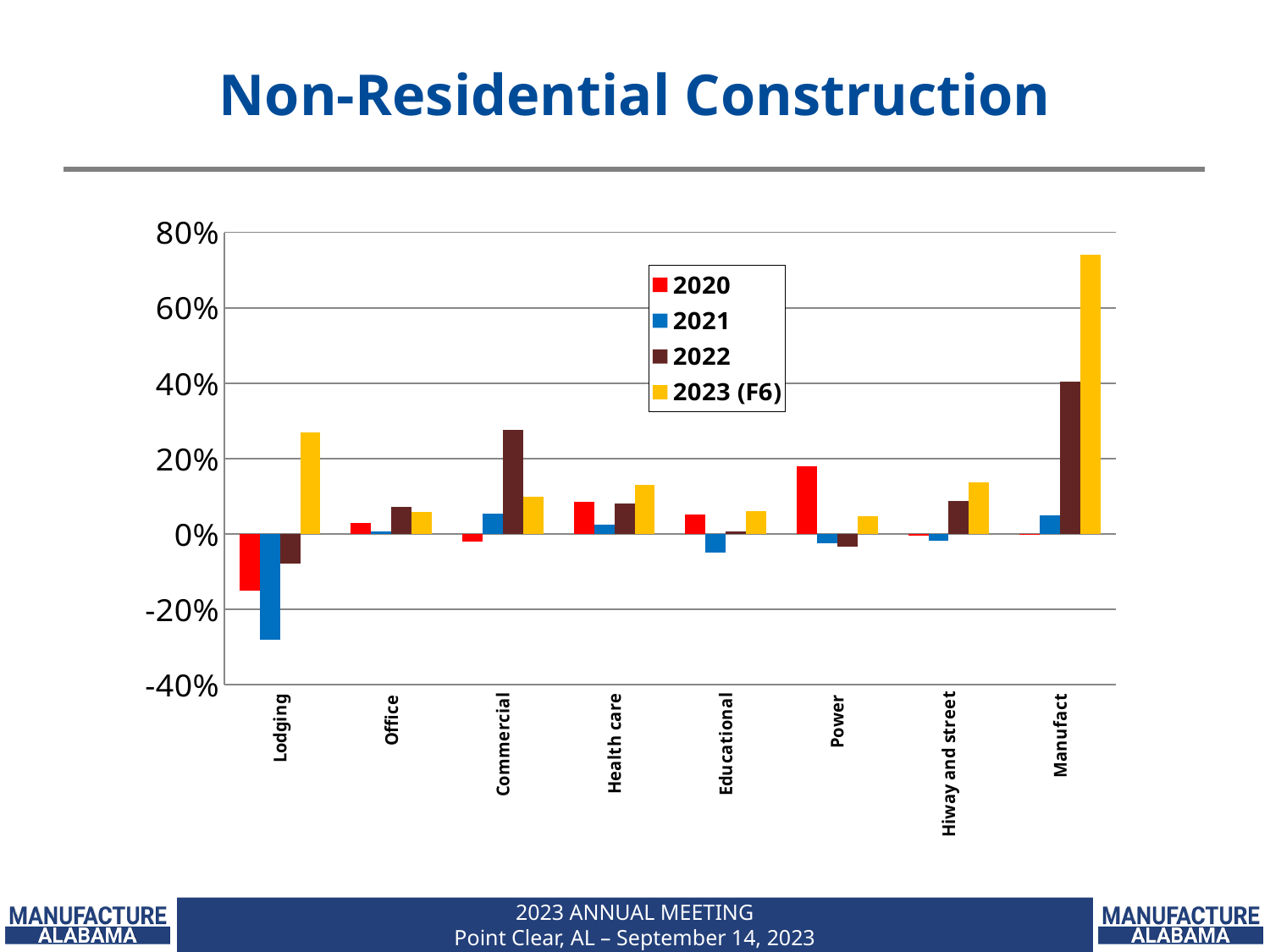
How many series does the legend list? 4 For Commercial, which series has the larger value: 2022 or 2023 (F6)? 2022 Is the 2021 value for Lodging greater or less than -20%? less Which category has the highest value for the 2022 series? Manufact Is the 2023 (F6) value for Lodging greater or less than 20%? greater For Power, which series has the larger value: 2020 or 2023 (F6)? 2020 Which category has the lowest value for the 2021 series? Lodging What colour represents the 2023 (F6) series in the legend? yellow Is the 2023 (F6) value for Manufact greater or less than 60%? greater Which category has the highest value for the 2023 (F6) series? Manufact How many categories are shown along the x axis? 8 What kind of chart is shown on the slide? bar chart